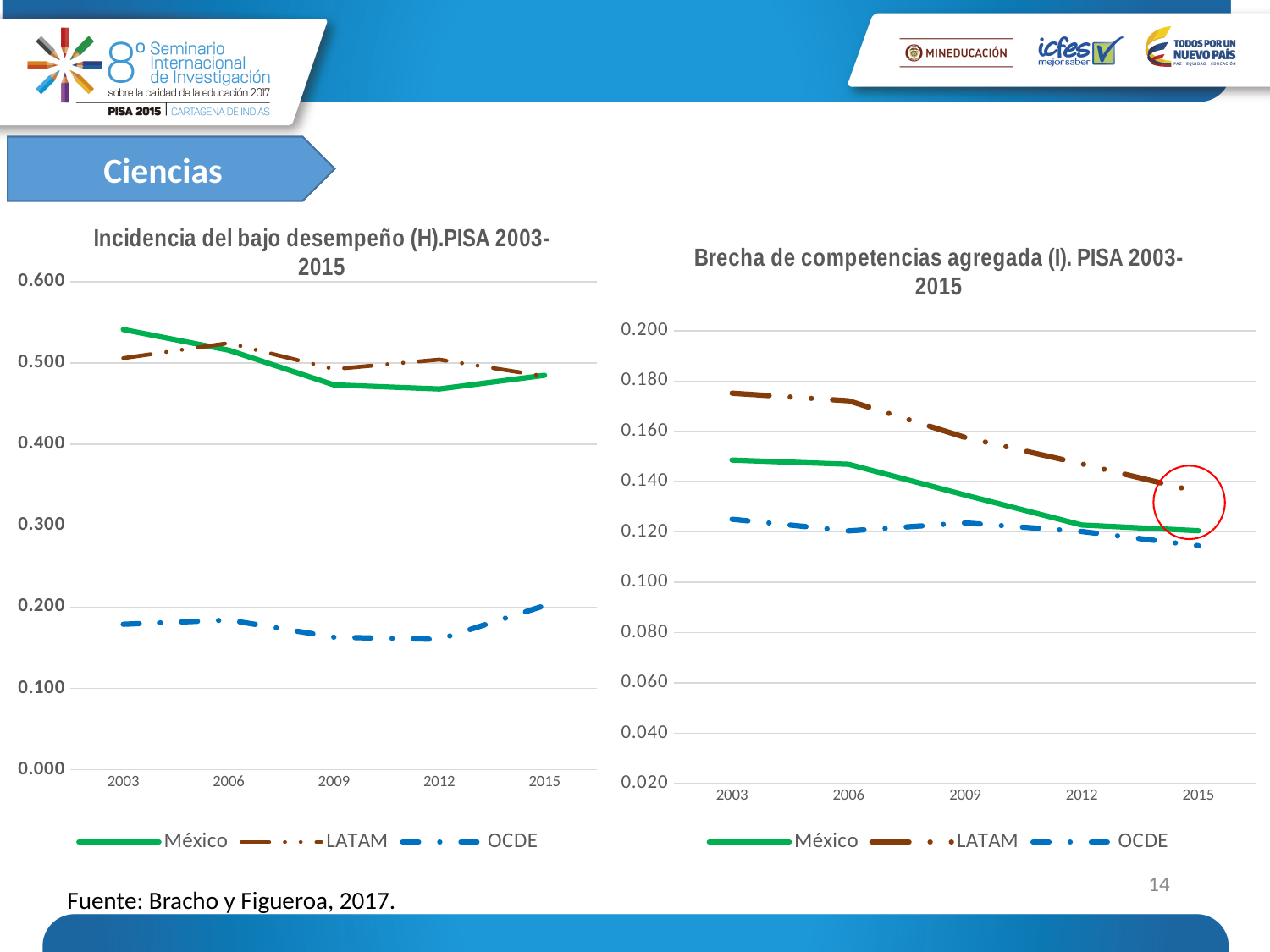
What kind of chart is the left chart, 'Incidencia del bajo desempeño (H).PISA 2003-2015'? Line chart In the left chart 'Incidencia del bajo desempeño', which series has the highest value in 2003? México How many years are plotted along the x axis of the right chart 'Brecha de competencias agregada'? 5 How many series does the legend of the left chart 'Incidencia del bajo desempeño' list? 3 In the right chart 'Brecha de competencias agregada', which series has the lowest value in 2015? OCDE In the right chart 'Brecha de competencias agregada', is the value for LATAM in 2003 greater or less than 0.160? greater In the right chart, which series' 2015 point is highlighted with a red circle? LATAM In the left chart 'Incidencia del bajo desempeño', is the value for México in 2003 greater or less than 0.500? greater In the left chart 'Incidencia del bajo desempeño', is the value for OCDE in 2015 greater or less than 0.300? less In the right chart 'Brecha de competencias agregada', which series has the larger value in 2015, LATAM or OCDE? LATAM In the left chart 'Incidencia del bajo desempeño', which series has the higher value in 2009, México or OCDE? México In the right chart 'Brecha de competencias agregada', does the México line rise or fall from 2003 to 2015? Falls